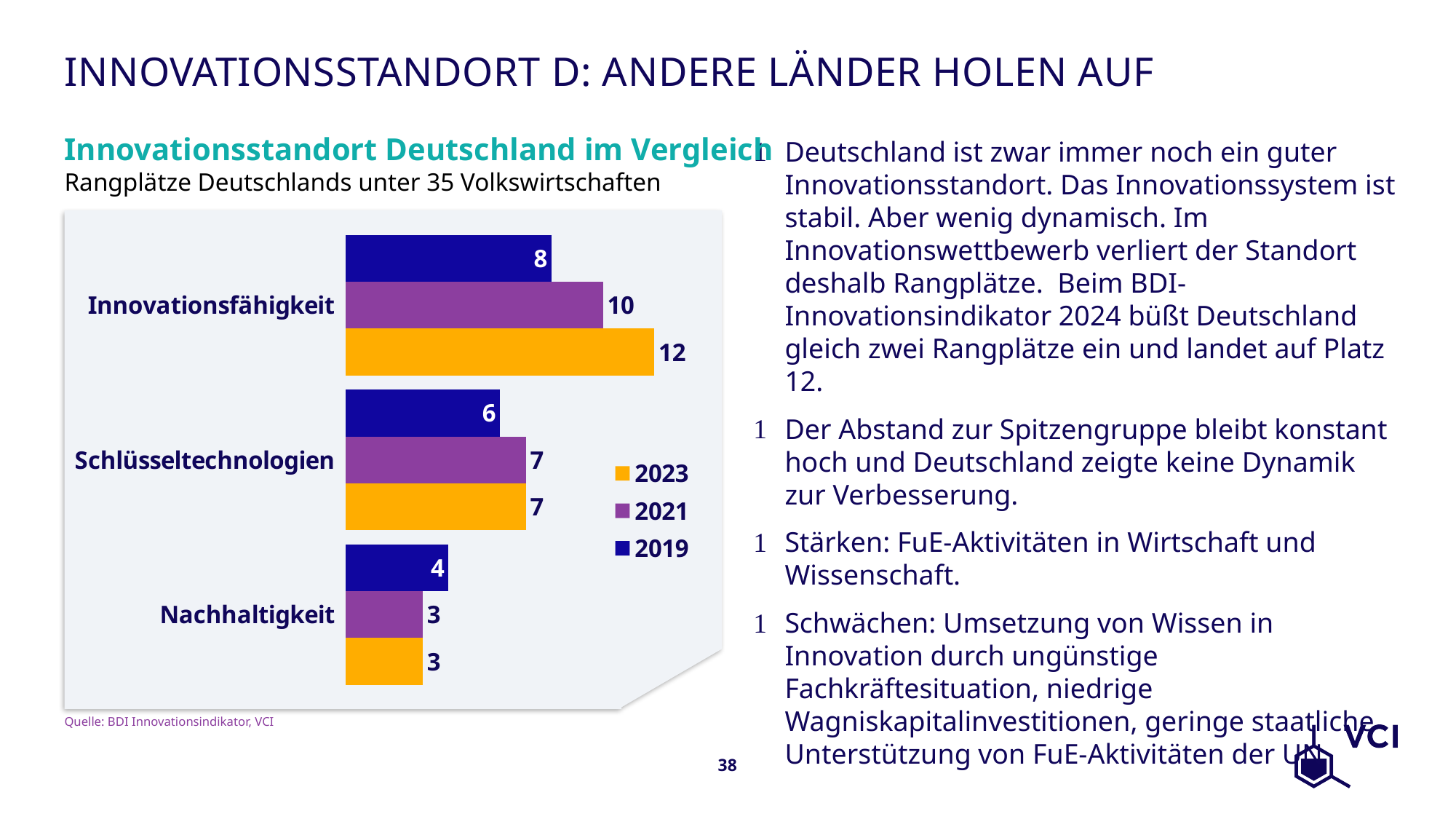
What is the 2019 value for Schlüsseltechnologien? 6 What is the 2021 value for Innovationsfähigkeit? 10 Which category has the highest 2023 value? Innovationsfähigkeit What kind of chart is shown on the slide? Bar chart How many series does the legend list? 3 What is the difference between the 2023 and 2019 values for Innovationsfähigkeit? 4 Which series is shown in orange in the legend? 2023 Which category has the lowest 2019 value? Nachhaltigkeit How many categories are shown on the chart? 3 What is the 2023 value for Innovationsfähigkeit? 12 What is the 2021 value for Nachhaltigkeit? 3 Which is larger for Nachhaltigkeit: the 2019 value or the 2023 value? 2019